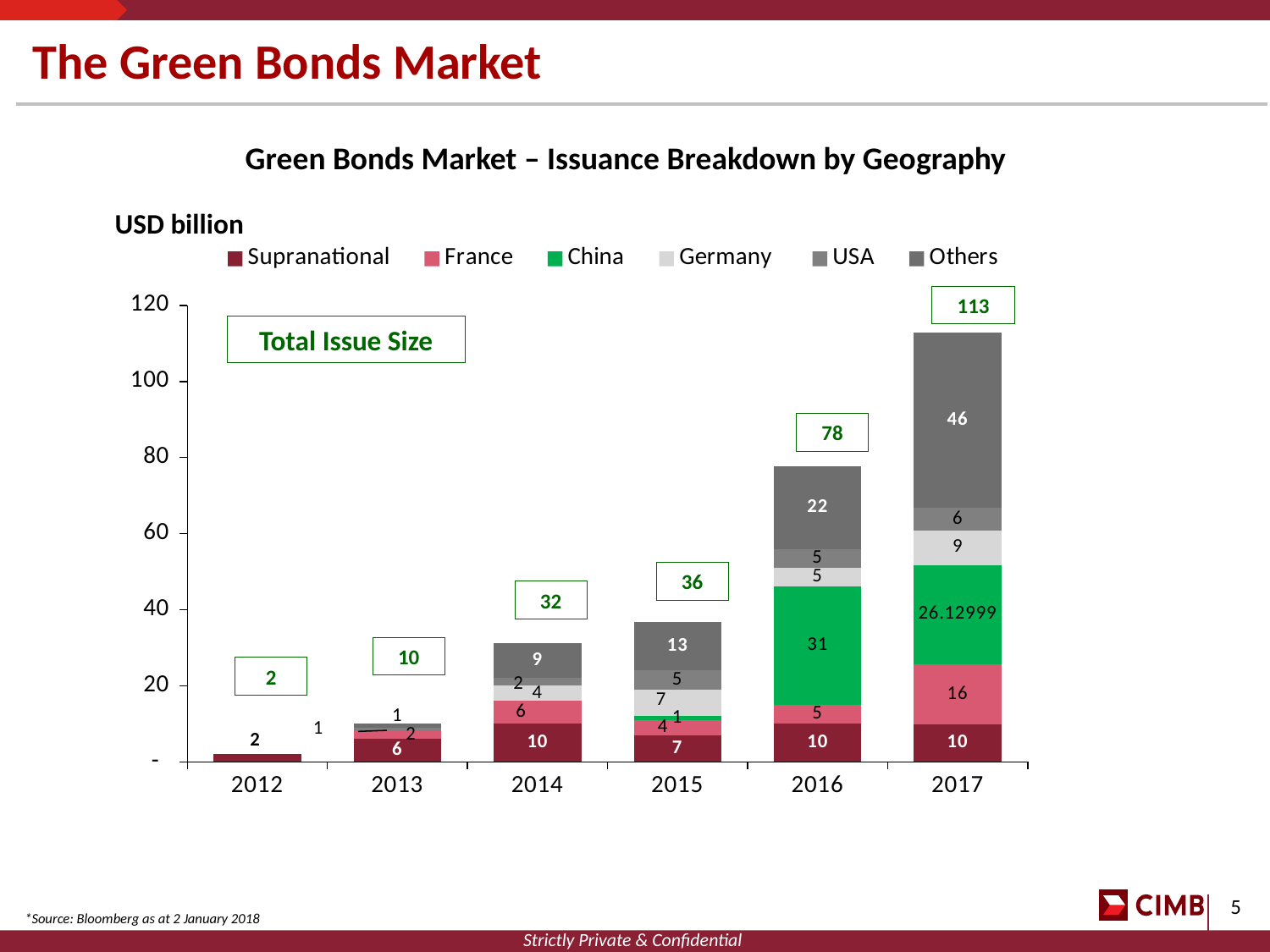
How many series does the legend list? 6 What is the total issue size for 2017? 113 Do the total issue sizes rise or fall from 2012 to 2017? Rise How many years are shown on the x axis? 6 Which year has the lowest total issue size? 2012 What type of chart is shown on the slide? Stacked bar chart What is the value for Others in 2017? 46 What is the value for France in 2017? 16 What is the difference between the total issue size in 2017 and in 2016? 35 What is the total issue size for 2016? 78 What is the value for China in 2016? 31 Which year has the highest total issue size? 2017